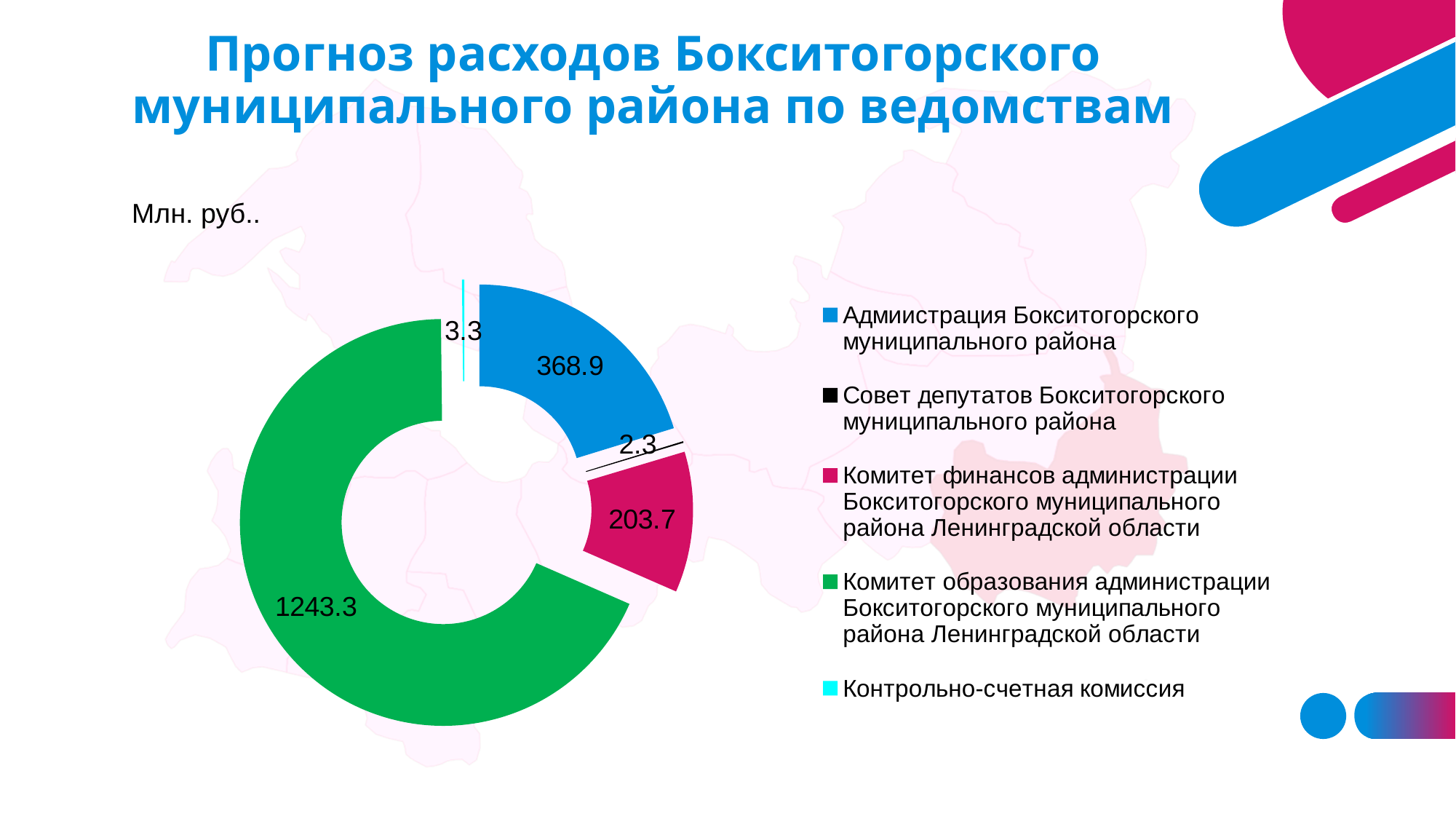
How many categories does the chart show? 5 Which is larger: the value for Комитет финансов or the value for Администрация Бокситогорского муниципального района? Администрация Бокситогорского муниципального района What is the value for Комитет финансов администрации Бокситогорского муниципального района Ленинградской области? 203.7 What is the difference between the values for Администрация Бокситогорского муниципального района and Комитет финансов? 165.2 Which category has the lowest value? Совет депутатов Бокситогорского муниципального района What kind of chart is shown on the slide? Doughnut chart What is the value for Контрольно-счетная комиссия? 3.3 Which category has the highest value? Комитет образования администрации Бокситогорского муниципального района Ленинградской области What is the value for Комитет образования администрации Бокситогорского муниципального района Ленинградской области? 1243.3 What is the value for Администрация Бокситогорского муниципального района? 368.9 What is the value for Совет депутатов Бокситогорского муниципального района? 2.3 What is the difference between the values for Комитет образования and Администрация Бокситогорского муниципального района? 874.4